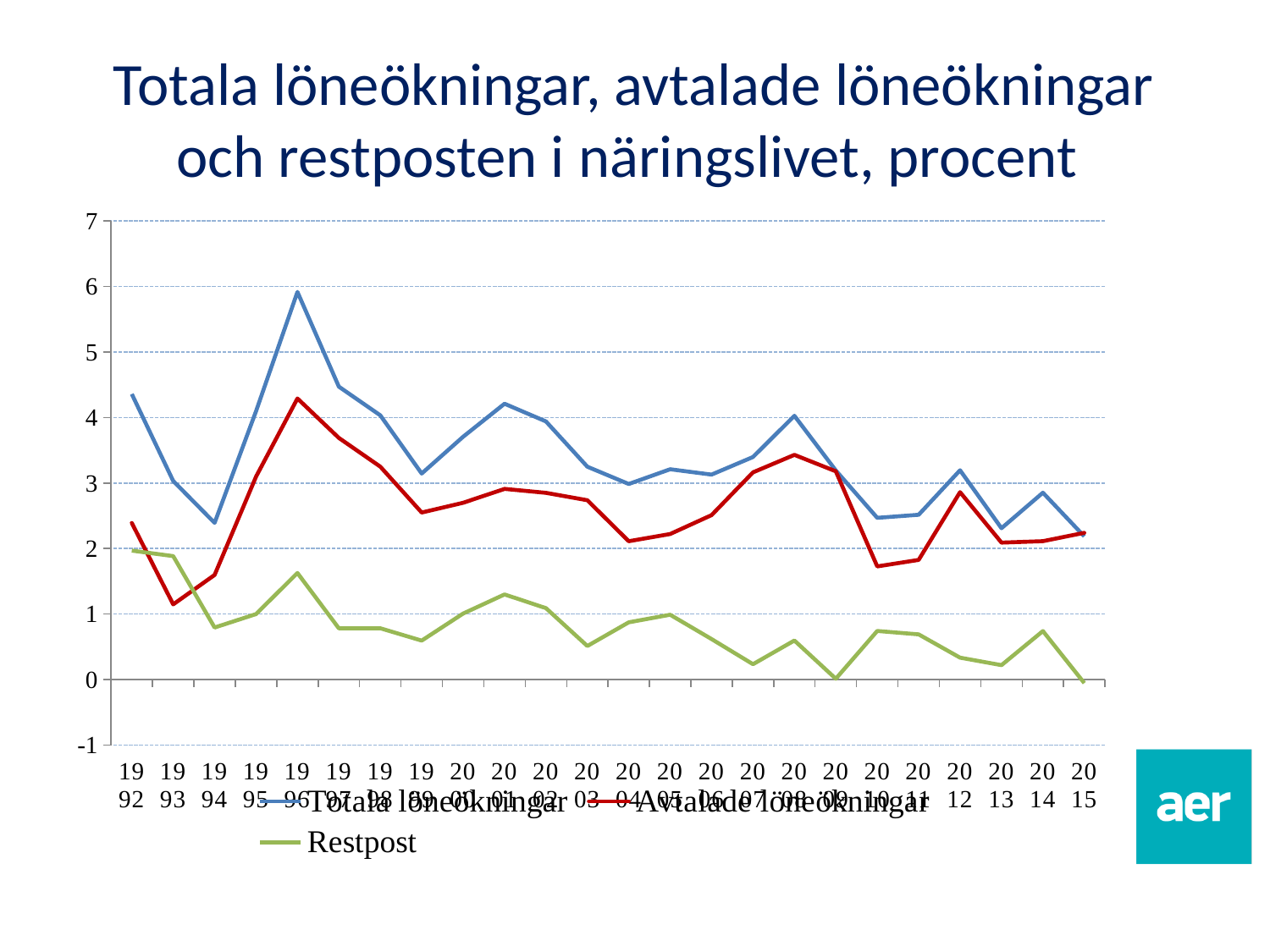
Which series is drawn in green? Restpost In which year does the Avtalade löneökningar series reach its lowest value? 1993 In which year does the Totala löneökningar series reach its highest value? 1996 In 1996, which series has the larger value: Totala löneökningar or Avtalade löneökningar? Totala löneökningar What kind of chart is shown on the slide? line chart Is the value for Totala löneökningar in 1994 greater or less than 3? less Is the value for Avtalade löneökningar in 2010 greater or less than 2? less How many years are plotted along the x axis? 24 Does the Restpost series overall rise or fall from 1992 to 2015? fall Is the value for Avtalade löneökningar in 1993 greater or less than 2? less How many series does the legend list? 3